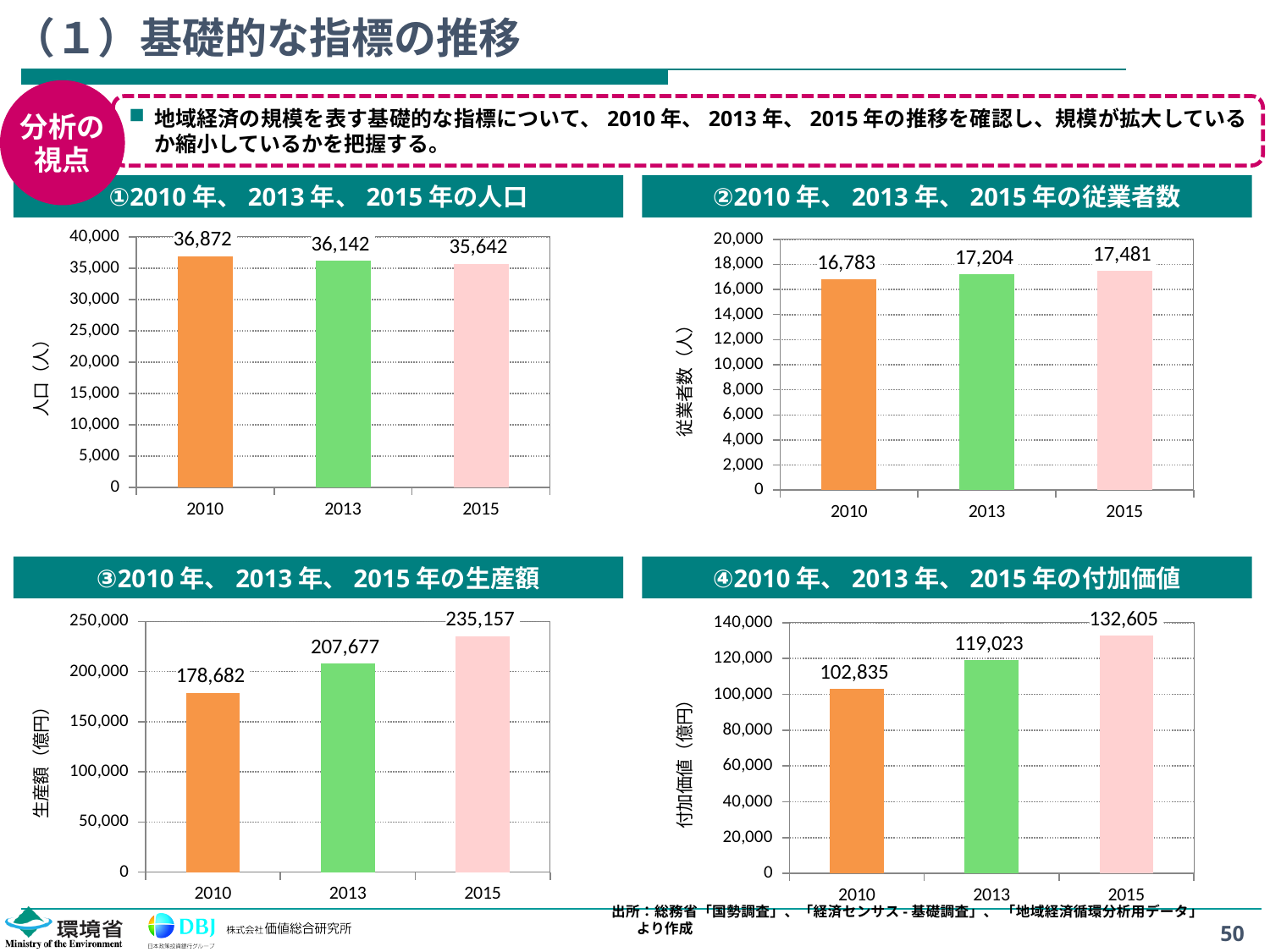
In the bottom-left chart (③2010年、2013年、2015年の生産額), is the value for 2013 greater or less than 200,000? greater In the bottom-left chart (③2010年、2013年、2015年の生産額), what is the value for 2015? 235,157 What kind of chart is the bottom-right chart (④2010年、2013年、2015年の付加価値)? bar chart In the top-right chart (②2010年、2013年、2015年の従業者数), what is the difference between the 2015 and 2010 values? 698 In the top-left chart (①2010年、2013年、2015年の人口), what is the value for 2010? 36,872 In the top-left chart (①2010年、2013年、2015年の人口), what is the difference between the 2010 and 2015 values? 1,230 In the top-right chart (②2010年、2013年、2015年の従業者数), what is the value for 2013? 17,204 In the top-right chart (②2010年、2013年、2015年の従業者数), which year has the highest value? 2015 In the top-left chart (①2010年、2013年、2015年の人口), which year has the lowest value? 2015 In the bottom-right chart (④2010年、2013年、2015年の付加価値), what is the value for 2010? 102,835 In the top-left chart (①2010年、2013年、2015年の人口), do the values rise or fall from 2010 to 2015? fall In the bottom-right chart (④2010年、2013年、2015年の付加価値), what is the difference between the 2015 and 2010 values? 29,770